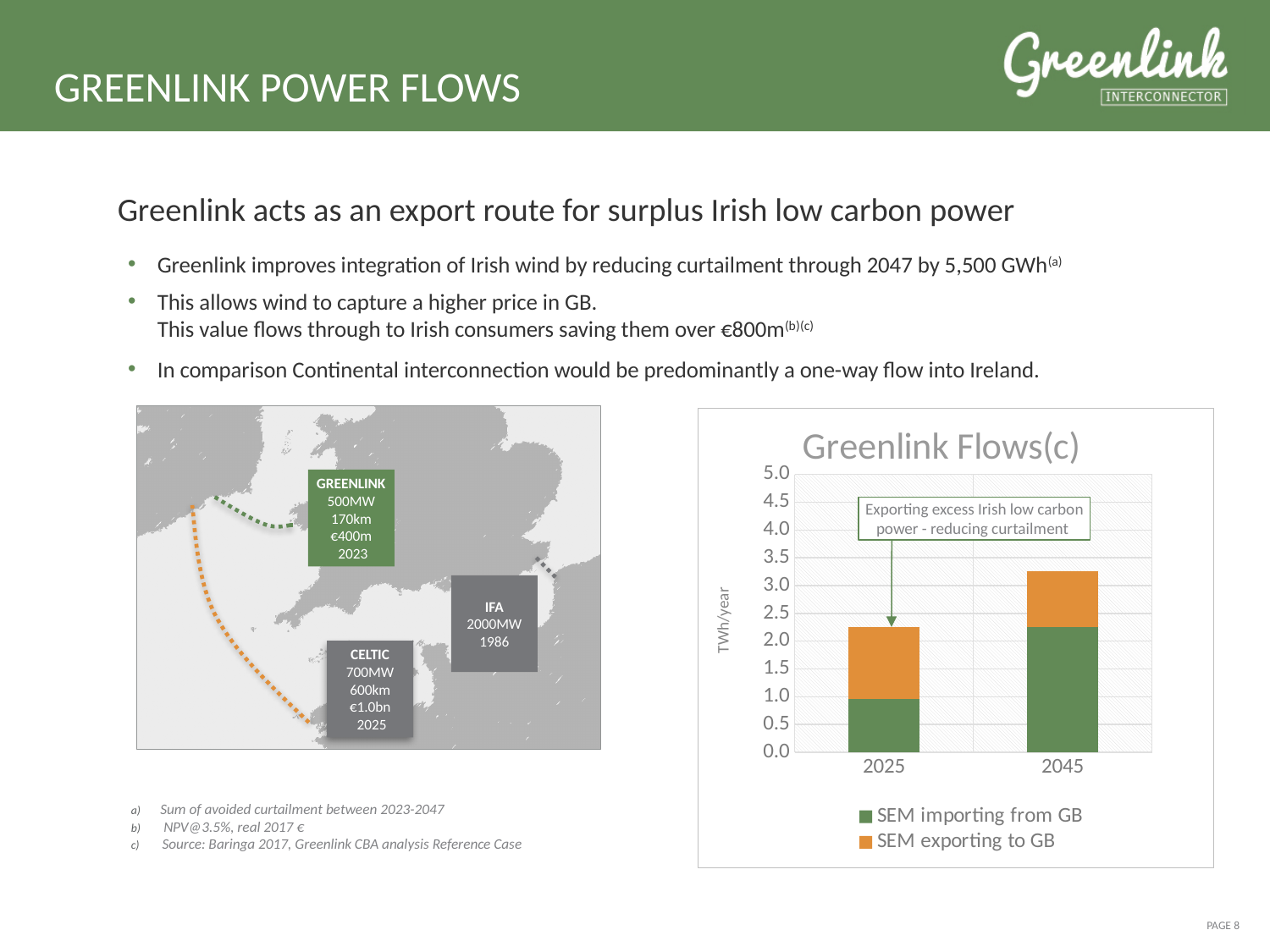
In the "Greenlink Flows(c)" chart, which year has the larger total stacked bar, 2025 or 2045? 2045 In the "Greenlink Flows(c)" chart, does the total flow rise or fall from 2025 to 2045? Rise In the "Greenlink Flows(c)" chart, is the "SEM importing from GB" value for 2045 greater or less than 1.5 TWh/year? greater In the "Greenlink Flows(c)" chart, which series is shown in orange? SEM exporting to GB In the "Greenlink Flows(c)" chart, is the total stacked value for 2045 greater or less than 3.0 TWh/year? greater In the "Greenlink Flows(c)" chart, is the total stacked value for 2025 greater or less than 3.0 TWh/year? less How many series does the legend of the "Greenlink Flows(c)" chart list? 2 How many years are shown on the x axis of the "Greenlink Flows(c)" chart? 2 What type of chart is the "Greenlink Flows(c)" chart? Stacked bar chart In the "Greenlink Flows(c)" chart, which year has the larger "SEM importing from GB" value, 2025 or 2045? 2045 What is the y-axis label of the "Greenlink Flows(c)" chart? TWh/year